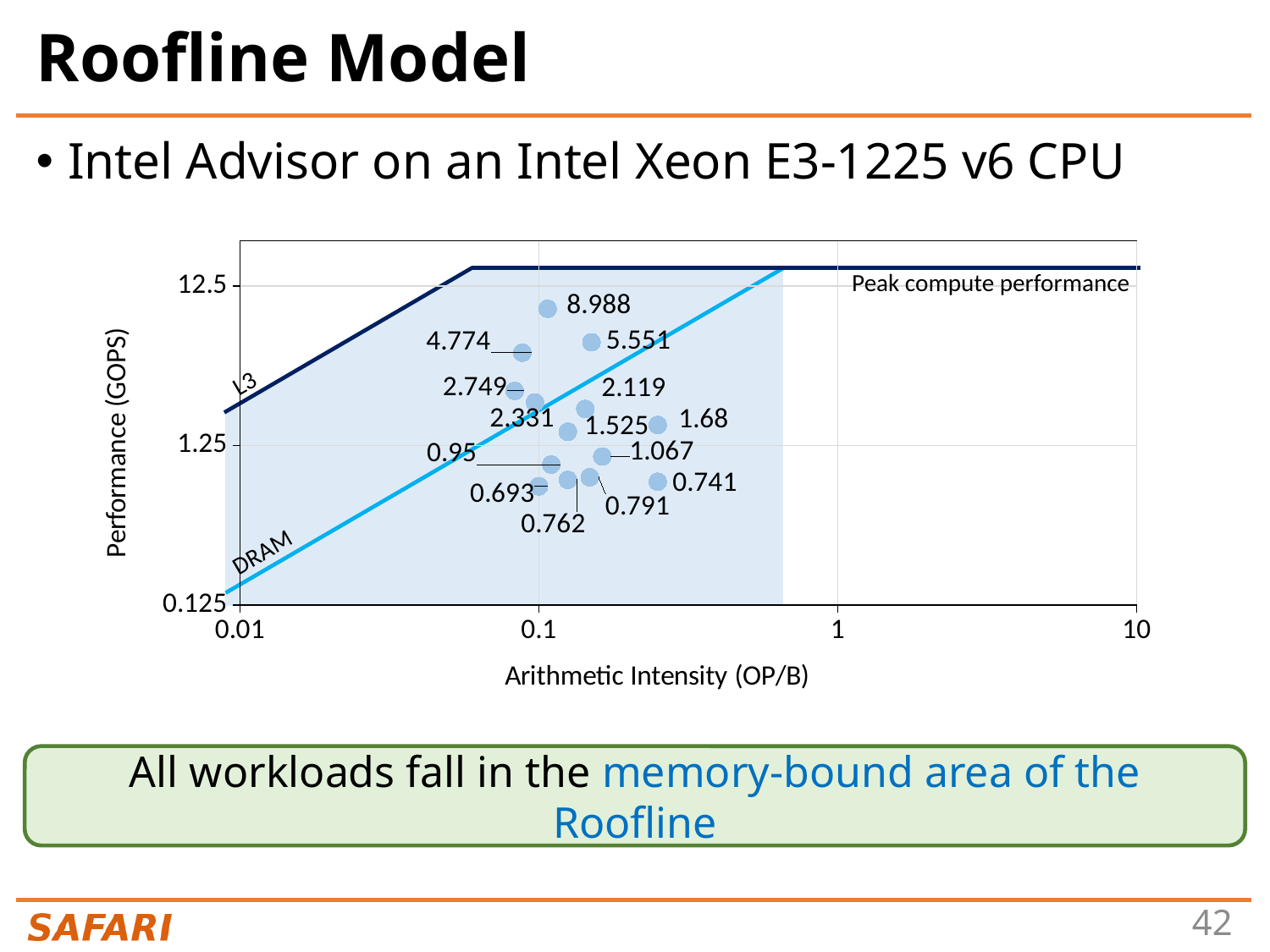
What kind of chart is shown on the slide? scatter chart Which labeled value is larger, 5.551 or 4.774? 5.551 What is the title of the x axis? Arithmetic Intensity (OP/B) What is the difference between the labeled values 5.551 and 4.774? 0.777 How many labeled points have a value greater than 5? 2 What is the difference between the labeled values 2.749 and 2.119? 0.63 What is the highest labeled performance value among the plotted points? 8.988 What label is given to the flat horizontal line at the top of the chart? Peak compute performance How many data points have value labels printed on the chart? 14 What is the lowest labeled performance value among the plotted points? 0.693 What is the difference between the highest labeled value (8.988) and the lowest labeled value (0.693)? 8.295 What is the second-highest labeled value on the chart? 5.551